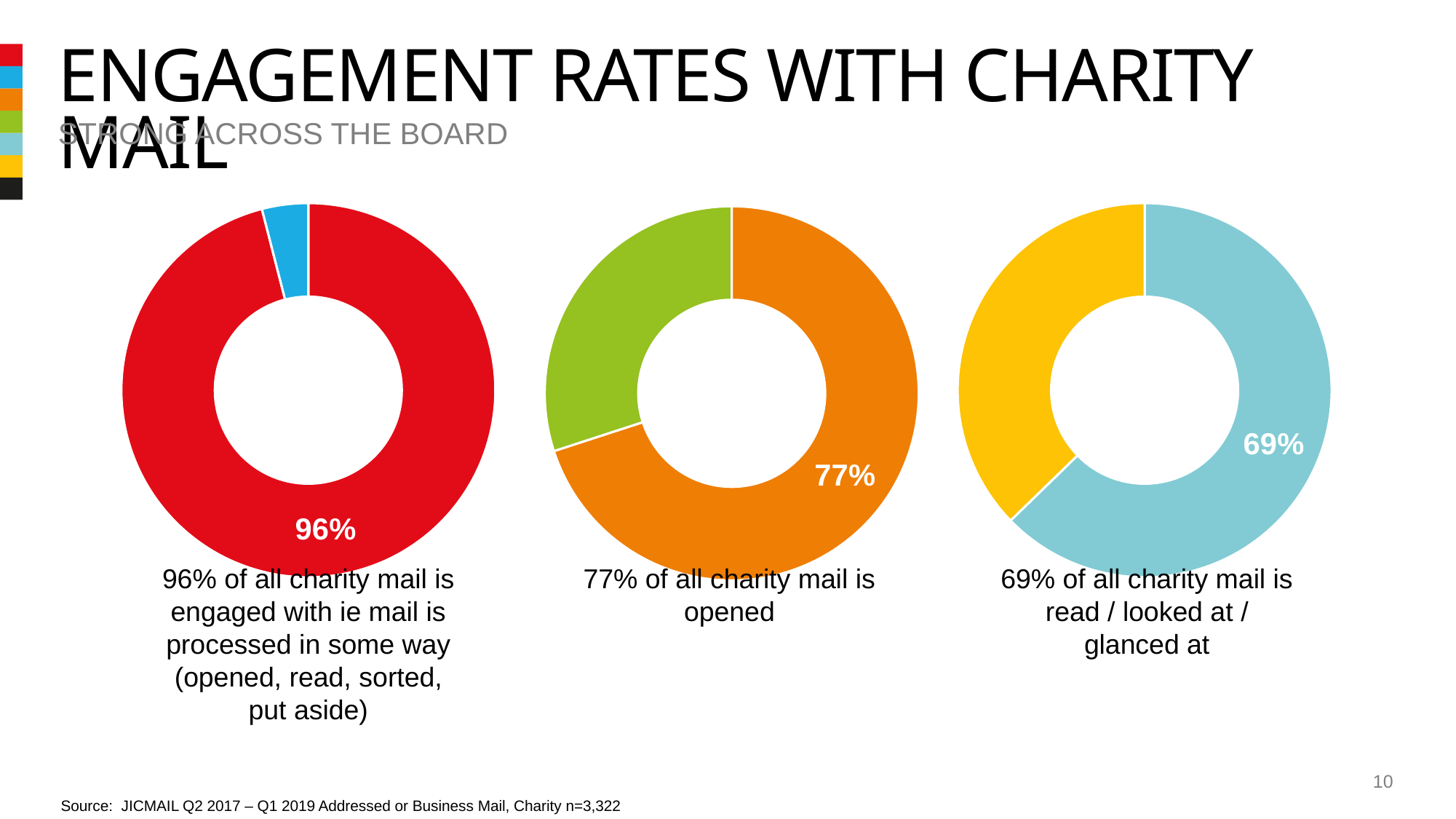
Which of the three charts shows the highest labelled percentage? The left-hand chart (96%) In the left-hand chart, what percentage of charity mail is engaged with? 96% Is the labelled share in the middle chart larger or smaller than the labelled share in the right-hand chart? Larger How many slices does the left-hand chart have? 2 What is the difference between the engaged-with percentage in the left-hand chart and the opened percentage in the middle chart? 19 percentage points In the middle chart, what percentage of charity mail is opened? 77% What is the difference between the opened percentage in the middle chart and the read / looked at / glanced at percentage in the right-hand chart? 8 percentage points In the right-hand chart, what percentage of charity mail is read / looked at / glanced at? 69% What kind of chart is used for each of the three charts on the slide? Doughnut (pie) chart What colour is the 77% slice in the middle chart? Orange Which of the three charts shows the lowest labelled percentage? The right-hand chart (69%) What colour is the 96% slice in the left-hand chart? Red